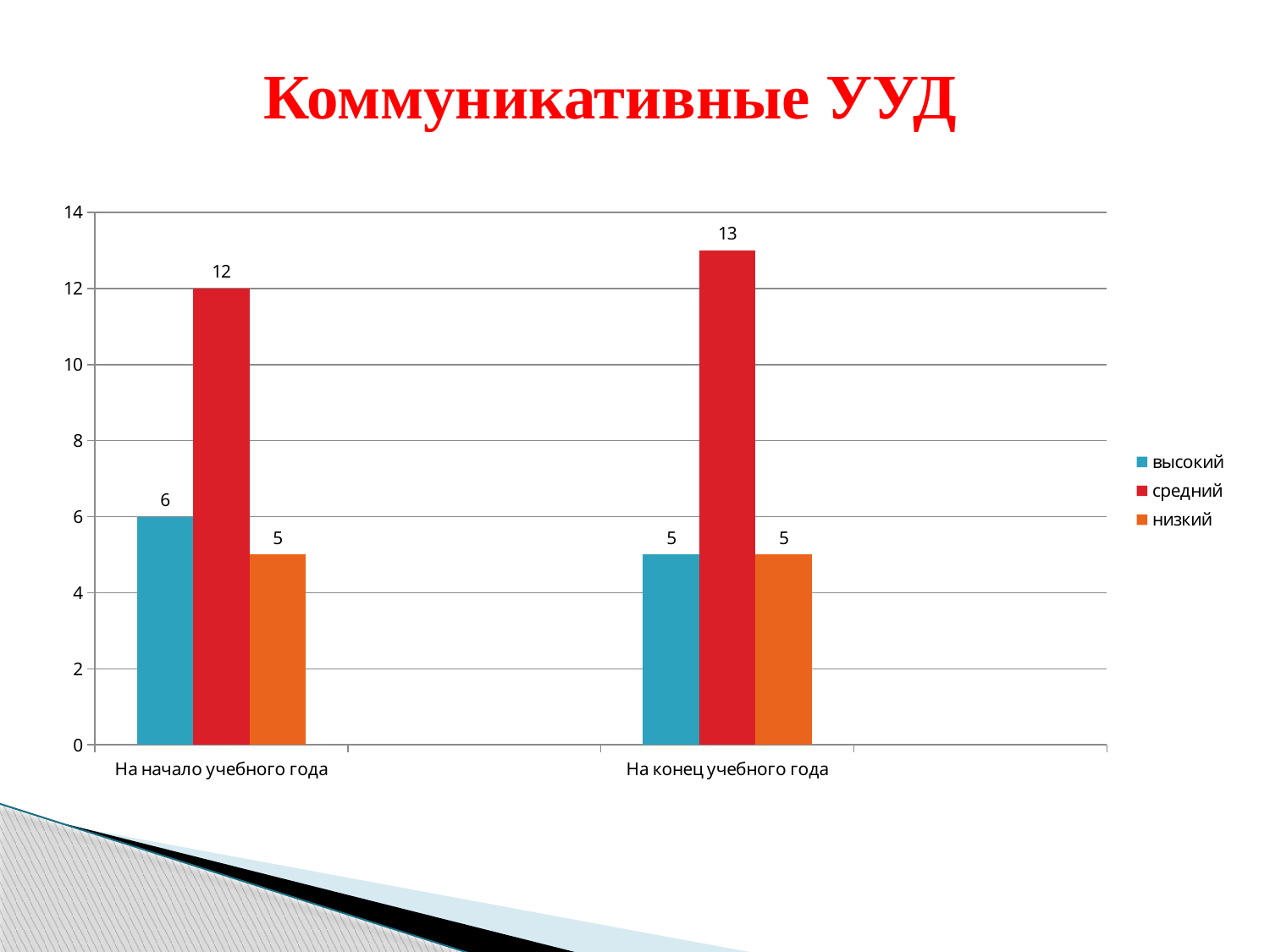
Which series has the lowest value at "На начало учебного года"? низкий Which series has the highest value at "На конец учебного года"? средний Does the "высокий" series rise or fall from "На начало учебного года" to "На конец учебного года"? fall How many series does the legend list? 3 What is the value for "низкий" at "На начало учебного года"? 5 Which is larger: the "высокий" value at "На начало учебного года" or at "На конец учебного года"? На начало учебного года What kind of chart is shown on the slide? bar chart How many categories are shown on the x axis? 2 What is the value for "средний" at "На начало учебного года"? 12 What is the title of the slide? Коммуникативные УУД What is the difference between the "средний" values at "На конец учебного года" and "На начало учебного года"? 1 What is the value for "высокий" at "На конец учебного года"? 5